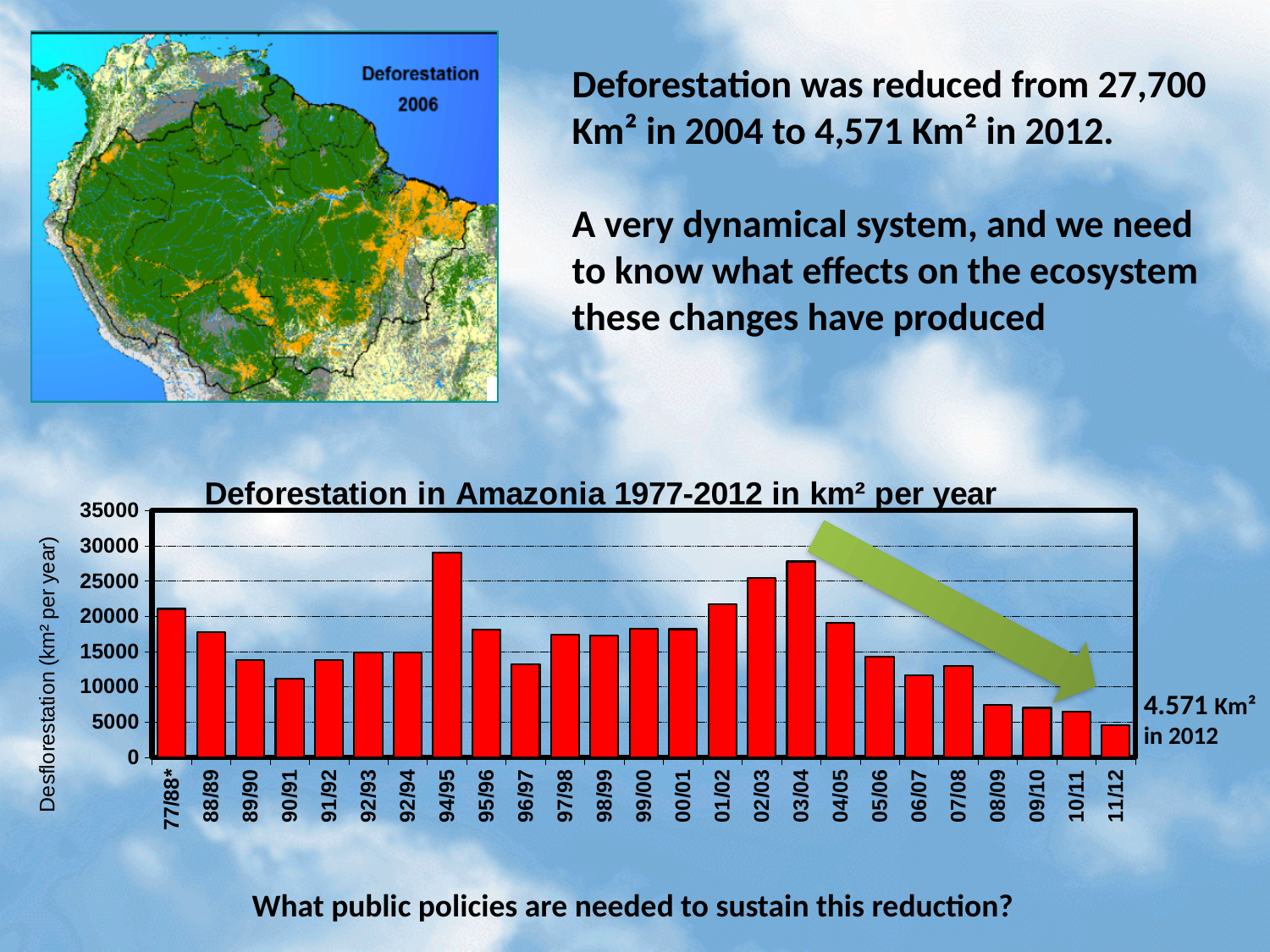
Which period has the highest deforestation value in the chart? 94/95 What deforestation value is labelled for the 11/12 bar? 4.571 Km² Is the value for 96/97 greater or less than 15000? less Do the values rise or fall from 03/04 to 11/12? fall Which period has the lowest deforestation value in the chart? 11/12 What type of chart is shown on the slide? bar chart What is the title of the chart? Deforestation in Amazonia 1977-2012 in km² per year Which is larger, the value for 02/03 or the value for 04/05? 02/03 Is the value for 94/95 greater or less than 25000? greater Is the value for 08/09 greater or less than 10000? less How many bars (periods) are plotted in the chart? 25 Which is larger, the value for 88/89 or the value for 89/90? 88/89